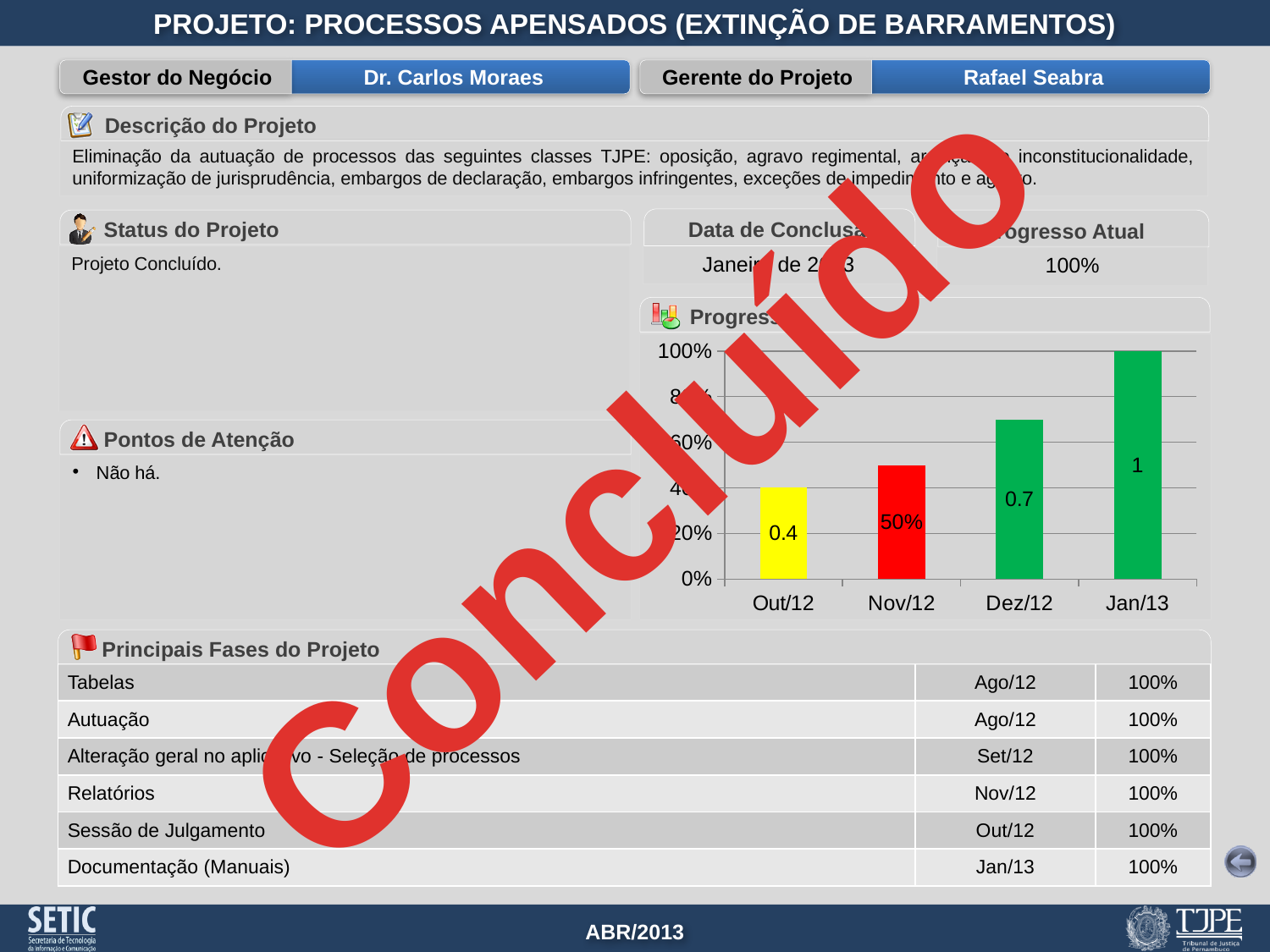
How many months are shown on the x axis of the progress chart? 4 Do the values in the progress chart rise or fall from Out/12 to Jan/13? rise What value is shown for Out/12 in the progress bar chart? 0.4 Which month has the highest bar in the progress chart? Jan/13 What is the difference between the values for Dez/12 and Out/12 in the progress chart? 0.3 What value is shown for Dez/12 in the progress bar chart? 0.7 What value is shown for Jan/13 in the progress bar chart? 1 What value is shown for Nov/12 in the progress bar chart? 50% Which is larger in the progress chart, the value for Nov/12 or the value for Dez/12? Dez/12 Is the value for Dez/12 in the progress chart greater or less than 60%? greater Which month has the lowest bar in the progress chart? Out/12 What kind of chart is used to show the progress over the months? bar chart